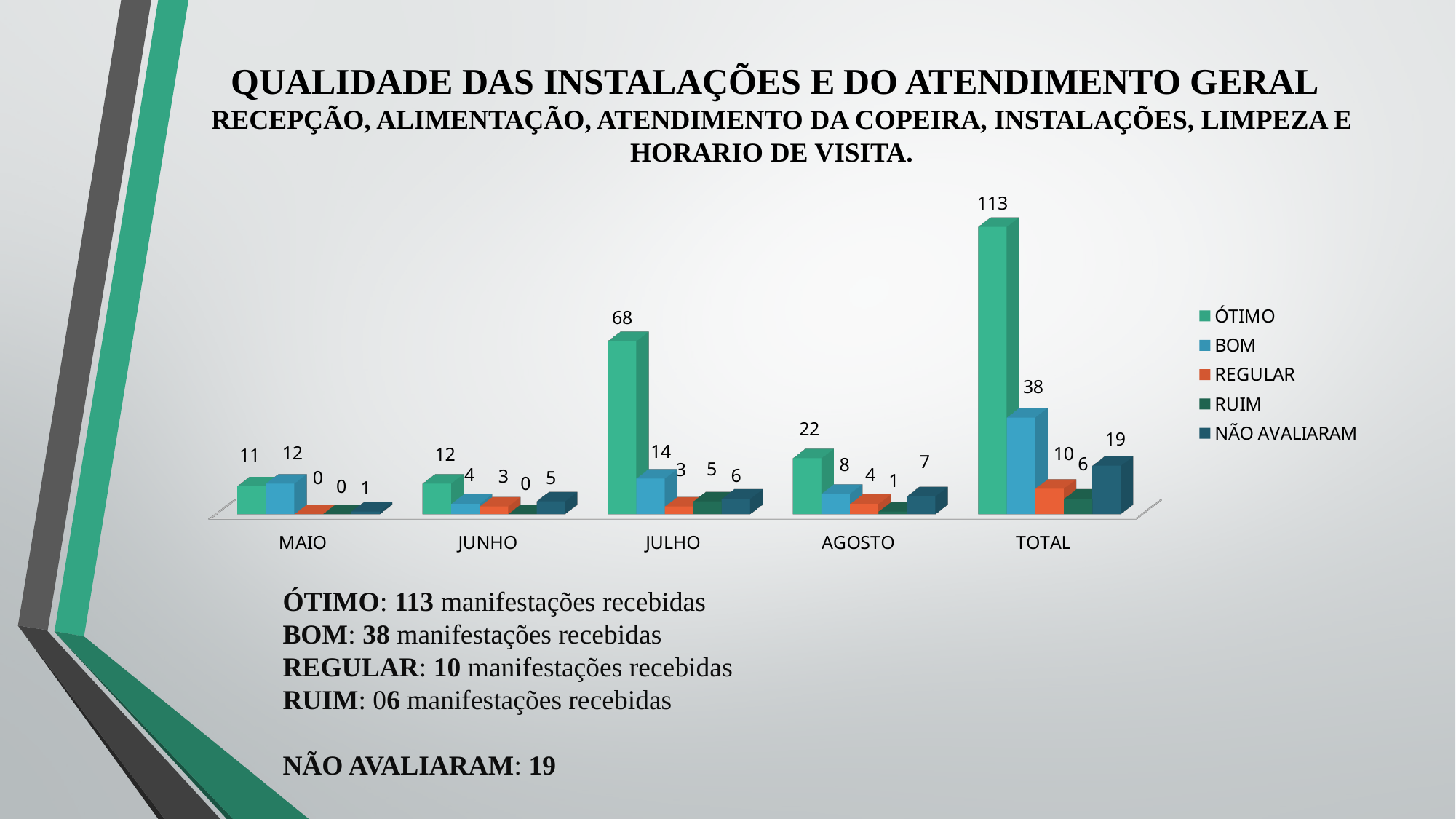
Which legend entry is shown in orange? REGULAR What is the difference between the ÓTIMO and BOM values in TOTAL? 75 How many series does the legend list? 5 What is the value for REGULAR in JUNHO? 3 Which is larger in MAIO, ÓTIMO or BOM? BOM What is the value for BOM in TOTAL? 38 What kind of chart is shown on the slide? Bar chart Which month (excluding TOTAL) has the highest ÓTIMO value? JULHO How many categories are shown on the x axis? 5 Which series has the lowest value in TOTAL? RUIM What is the value for ÓTIMO in JULHO? 68 What is the value for NÃO AVALIARAM in AGOSTO? 7